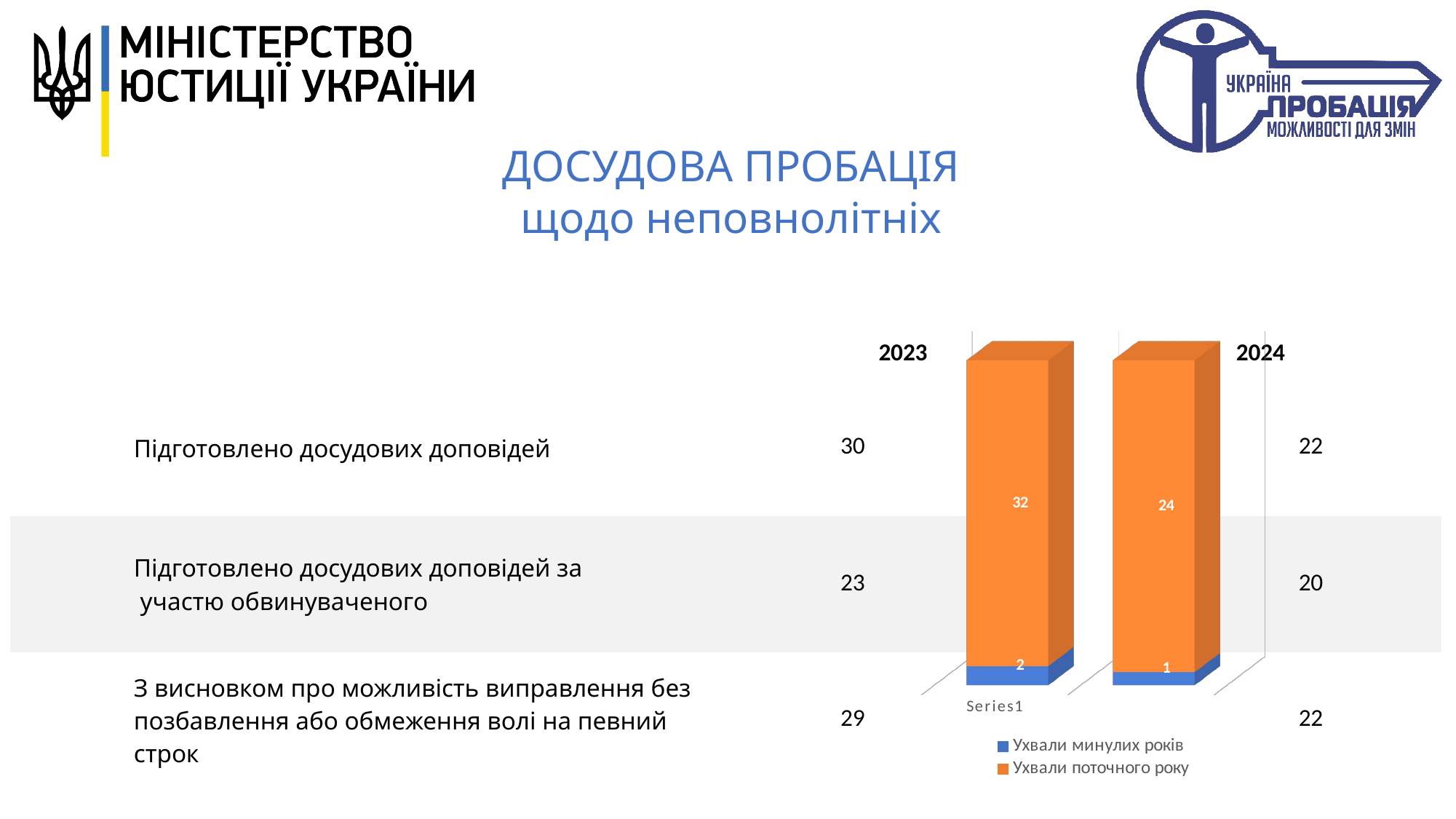
What is the value of the orange segment (Ухвали поточного року) for the 2023 bar? 32 What is the total of the stacked bar for 2023? 34 What is the total of the stacked bar for 2024? 25 What is the difference between the Ухвали поточного року values for 2023 and 2024? 8 Which legend entry is shown in orange? Ухвали поточного року What is the value of the blue segment (Ухвали минулих років) for the 2023 bar? 2 What is the value of the orange segment (Ухвали поточного року) for the 2024 bar? 24 What kind of chart is shown on the slide? bar chart What is the value of the blue segment (Ухвали минулих років) for the 2024 bar? 1 Which year has the larger Ухвали поточного року value, 2023 or 2024? 2023 How many bars are plotted in the chart? 2 How many series does the chart legend list? 2